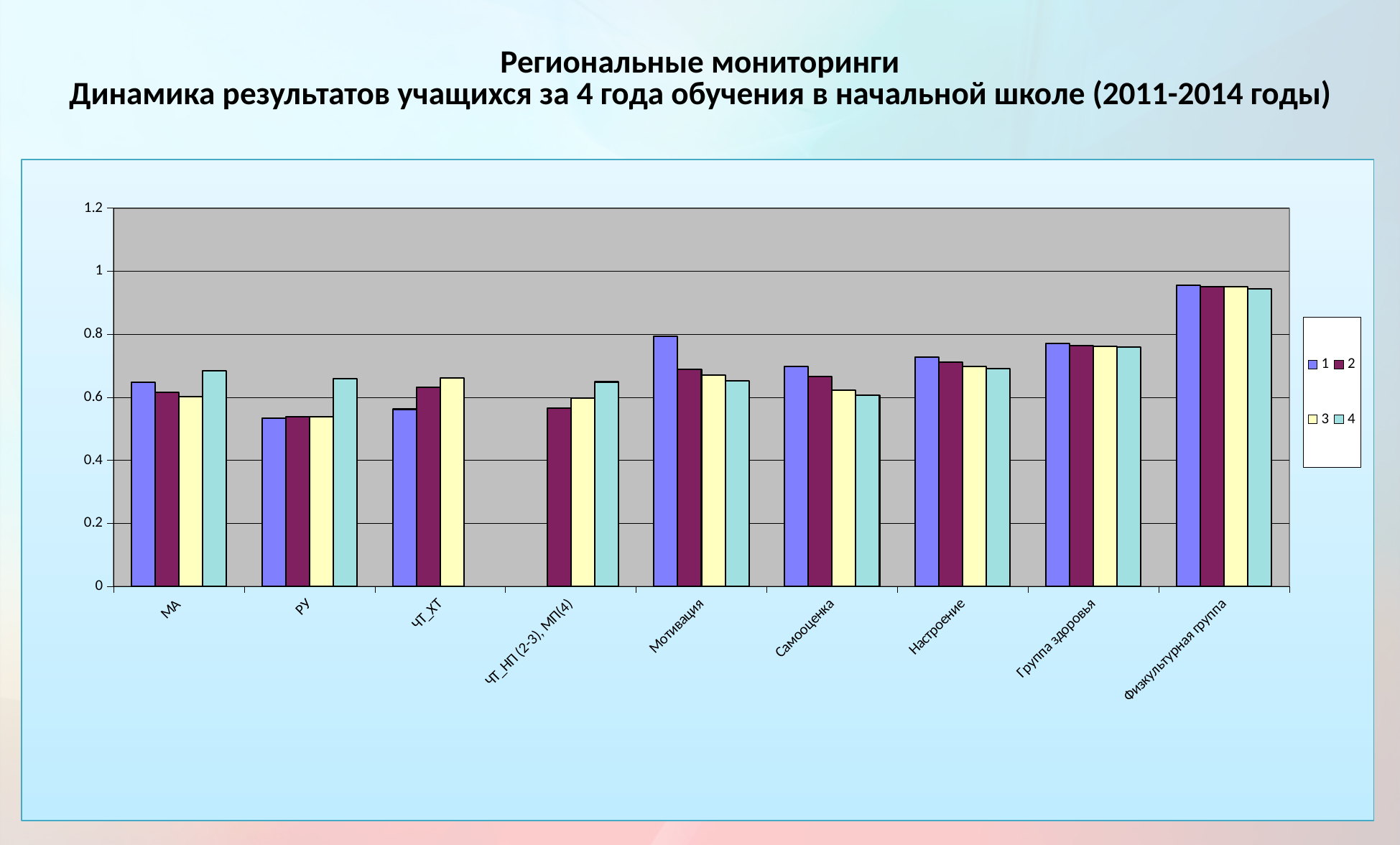
For Самооценка, do the values rise or fall from series 1 to series 4? fall Which category has the highest value for series 1? Физкультурная группа How many series does the legend list? 4 Which category has no bar for series 1? ЧТ_НП (2-3), МП(4) Is the value for series 1 in Физкультурная группа greater or less than 0.8? greater Is the value for series 1 in РУ greater or less than 0.6? less What kind of chart is shown on the slide? bar chart For Мотивация, which is larger: the value for series 1 or series 4? series 1 Is the value for series 4 in Самооценка greater or less than 0.8? less For РУ, which is larger: the value for series 1 or series 4? series 4 How many categories are shown on the x axis? 9 Which category has the lowest value for series 1? РУ